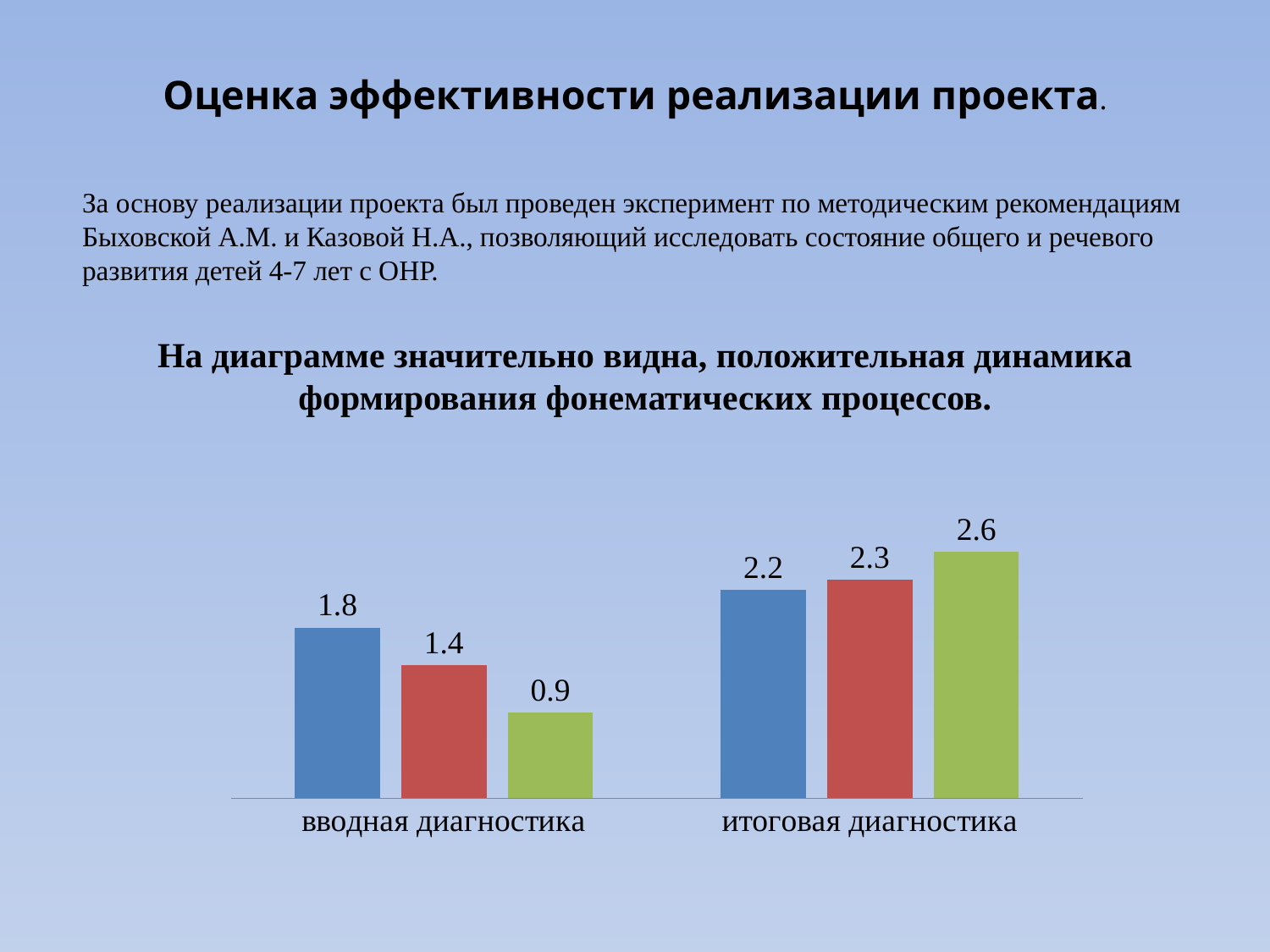
What is the difference between the green bar values for "итоговая диагностика" and "вводная диагностика"? 1.7 Which bar has the lowest value in the chart? the green bar for вводная диагностика (0.9) What is the value of the green bar for "итоговая диагностика"? 2.6 Which is larger: the red bar for "вводная диагностика" or the red bar for "итоговая диагностика"? итоговая диагностика What is the value of the red bar for "итоговая диагностика"? 2.3 Do the values rise or fall from "вводная диагностика" to "итоговая диагностика"? rise What type of chart is shown on the slide? bar chart What is the value of the green bar for "вводная диагностика"? 0.9 How many categories are shown on the x axis of the chart? 2 Which bar has the highest value in the chart? the green bar for итоговая диагностика (2.6) What is the difference between the blue bar values for "итоговая диагностика" and "вводная диагностика"? 0.4 What is the value of the blue bar for "вводная диагностика"? 1.8